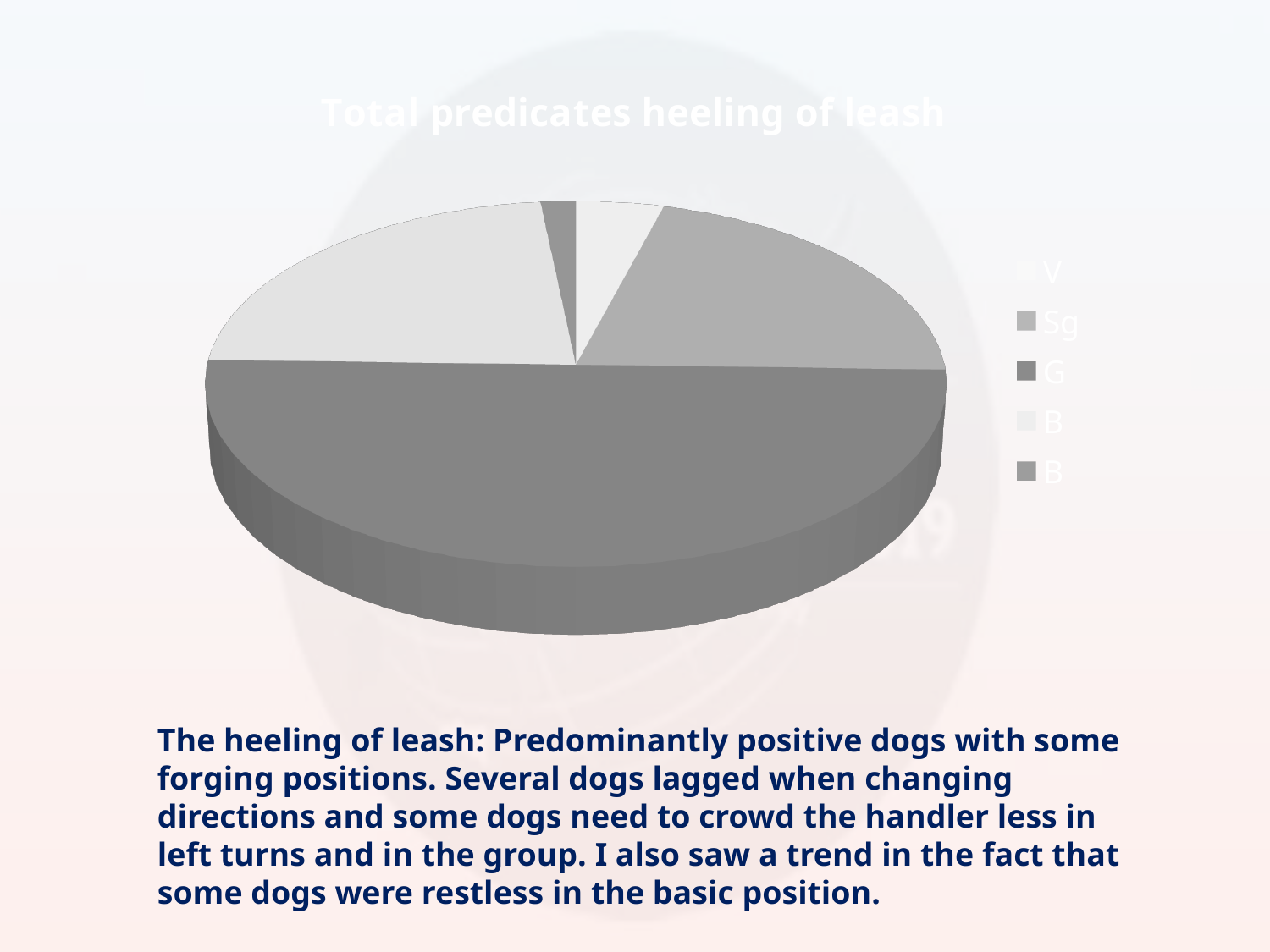
What kind of chart is shown on the slide? pie chart What is the title of the chart? Total predicates heeling of leash How many slices does the pie chart have? 5 How many entries does the chart's legend list? 5 Which slice is larger, G or Sg? G Which slice is larger, Sg or V? Sg Which category has the largest slice of the pie? G What is the first entry listed in the legend? V